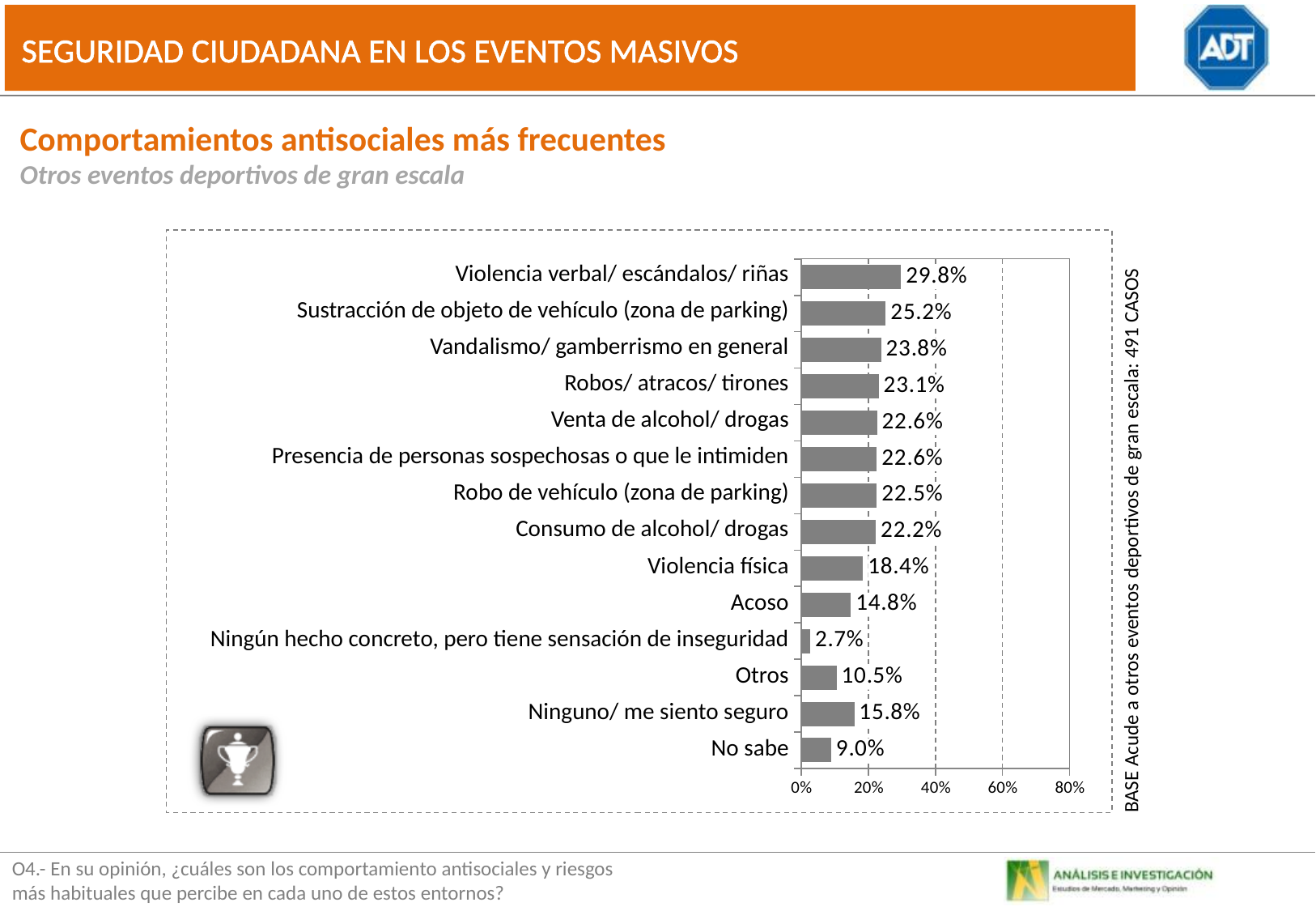
Which is larger, "Violencia física" or "Ninguno/ me siento seguro"? Violencia física What is the base (number of cases) stated next to the chart? 491 casos How many categories are shown in the chart? 14 What is the value for "Violencia verbal/ escándalos/ riñas"? 29.8% Is the value for "Vandalismo/ gamberrismo en general" greater or less than 20%? greater What is the value for "Acoso"? 14.8% What kind of chart is shown on the slide? bar chart Which category has the highest value? Violencia verbal/ escándalos/ riñas Which category has the lowest value? Ningún hecho concreto, pero tiene sensación de inseguridad What is the value for "Otros"? 10.5% What is the difference between "Violencia verbal/ escándalos/ riñas" and "Sustracción de objeto de vehículo (zona de parking)"? 4.6% What is the value for "No sabe"? 9.0%